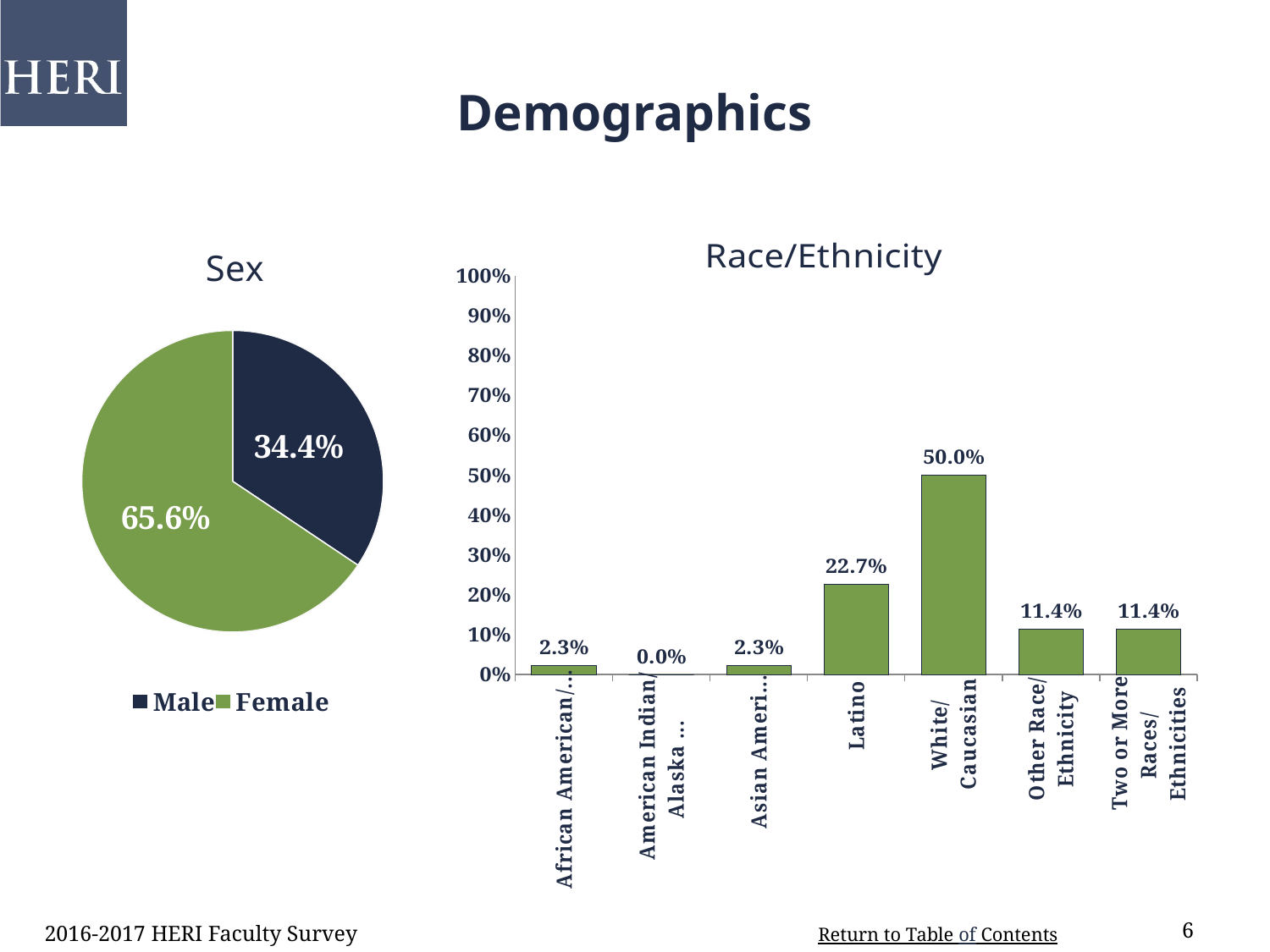
In the Sex chart, which is larger, Male or Female? Female In the Race/Ethnicity chart, what is the value for Latino? 22.7% In the Sex chart, what share of the pie is Male? 34.4% How many entries does the legend of the Sex chart list? 2 In the Race/Ethnicity chart, what is the value for White/Caucasian? 50.0% What kind of chart is the Sex chart? pie chart In the Race/Ethnicity chart, which category has the highest value? White/Caucasian What kind of chart is the Race/Ethnicity chart? bar chart In the Race/Ethnicity chart, what is the difference between White/Caucasian and Latino? 27.3% In the Sex chart, what share of the pie is Female? 65.6% In the Race/Ethnicity chart, is the value for Latino greater or less than 20%? greater How many categories are shown in the Race/Ethnicity chart? 7